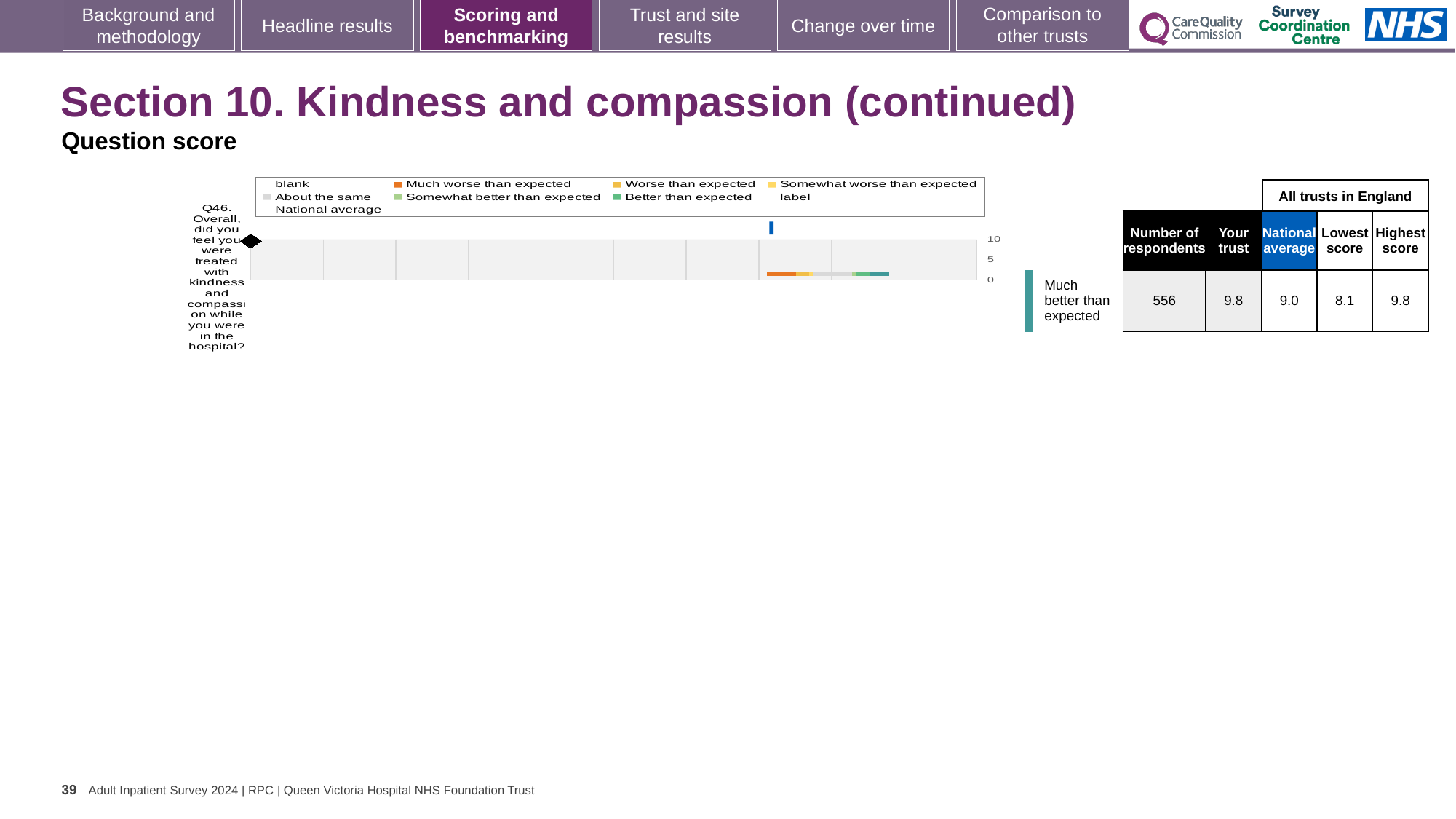
Which is larger for Q46, the trust's score or the national average? the trust's score What is the lowest score among all trusts in England for Q46? 8.1 What kind of chart is shown on the slide? bar chart What is the highest value shown on the chart's score axis? 10 Which survey question is the chart about? Q46 What is the national average score for Q46? 9.0 What colour in the legend represents 'Much worse than expected'? orange How many entries does the chart legend list? 9 How many respondents answered Q46? 556 What is the trust's score for Q46? 9.8 What is the difference between the trust's score and the national average for Q46? 0.8 What is the highest score among all trusts in England for Q46? 9.8